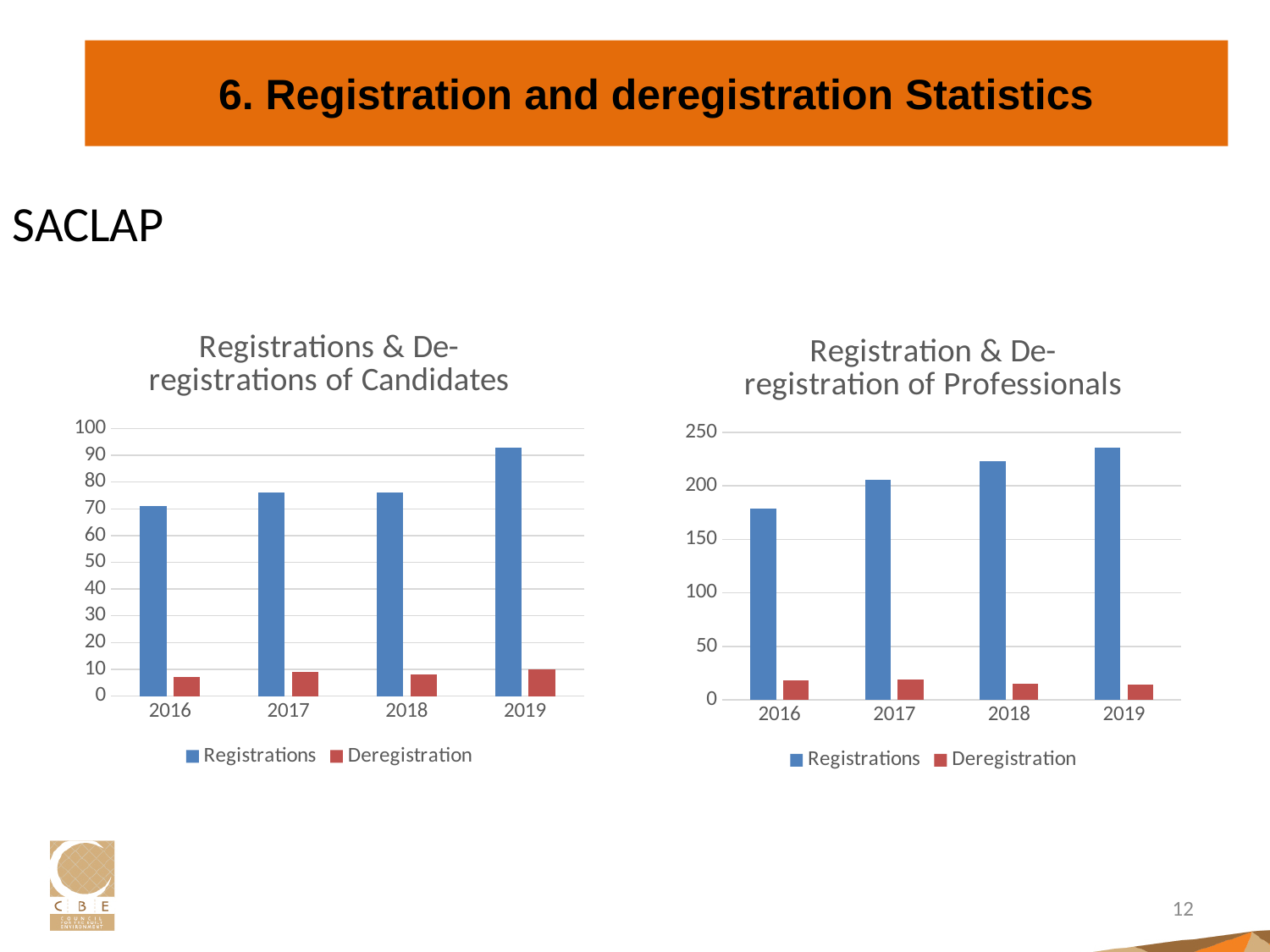
In the 'Registration & De-registration of Professionals' chart, is the Registrations value for 2018 greater or less than 200? greater How many series does the legend list in the 'Registrations & De-registrations of Candidates' chart? 2 In the 'Registrations & De-registrations of Candidates' chart, which year has the highest Registrations value? 2019 In the 'Registration & De-registration of Professionals' chart, is the Registrations value for 2016 greater or less than 200? less In the 'Registration & De-registration of Professionals' chart, which year has the highest Registrations value? 2019 In the 'Registrations & De-registrations of Candidates' chart, is the Registrations value for 2019 greater or less than 90? greater In the 'Registrations & De-registrations of Candidates' chart, which is larger in 2018: Registrations or Deregistration? Registrations In the 'Registration & De-registration of Professionals' chart, which year has the lowest Registrations value? 2016 In the 'Registrations & De-registrations of Candidates' chart, which year has the lowest Registrations value? 2016 What kind of chart is the 'Registration & De-registration of Professionals' chart? bar chart In the 'Registration & De-registration of Professionals' chart, do the Registrations values rise or fall from 2016 to 2019? rise